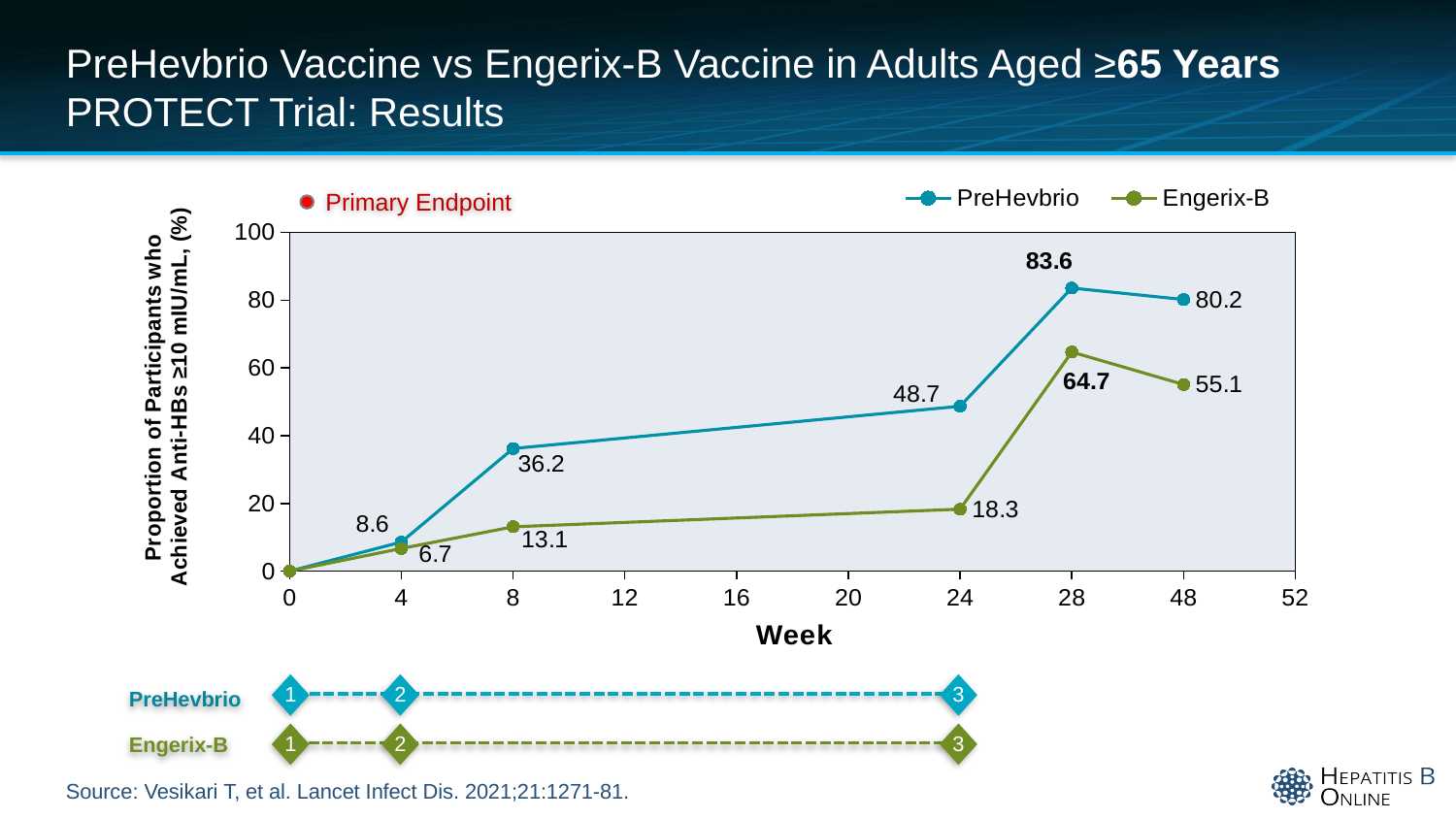
What is the value for PreHevbrio at week 8? 36.2 How many series does the legend list? 2 What is the difference between PreHevbrio and Engerix-B at week 24? 30.4 What is the difference between PreHevbrio and Engerix-B at week 28? 18.9 What is the value for Engerix-B at week 24? 18.3 What kind of chart is shown on the slide? Line chart At which week does PreHevbrio reach its highest value? 28 Which series has the larger value at week 48, PreHevbrio or Engerix-B? PreHevbrio Is the value for Engerix-B at week 28 greater or less than 60? greater Does the Engerix-B series rise or fall between week 28 and week 48? Fall What is the value for PreHevbrio at week 28? 83.6 What is the value for Engerix-B at week 48? 55.1